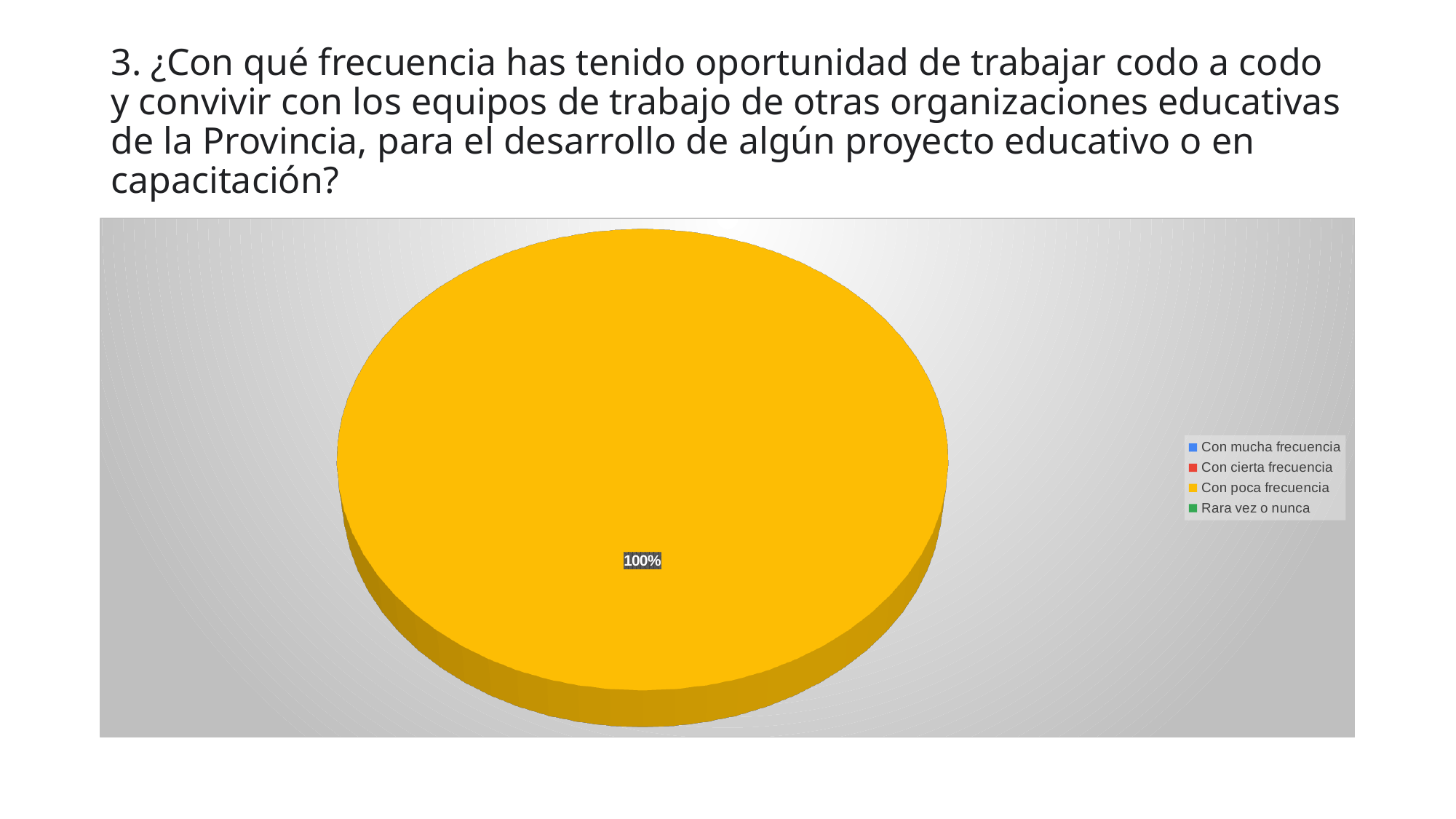
What share of the pie does "Con poca frecuencia" take? 100% Which is larger, the share for "Con poca frecuencia" or the share for "Con mucha frecuencia"? Con poca frecuencia Is the share for "Con poca frecuencia" greater or less than 50%? greater Which legend entry is shown in green? Rara vez o nunca Which category has the largest share of the pie? Con poca frecuencia What is the data label printed on the pie slice? 100% How many categories does the legend list? 4 What kind of chart is shown on the slide? pie chart Which legend entry is shown in yellow? Con poca frecuencia